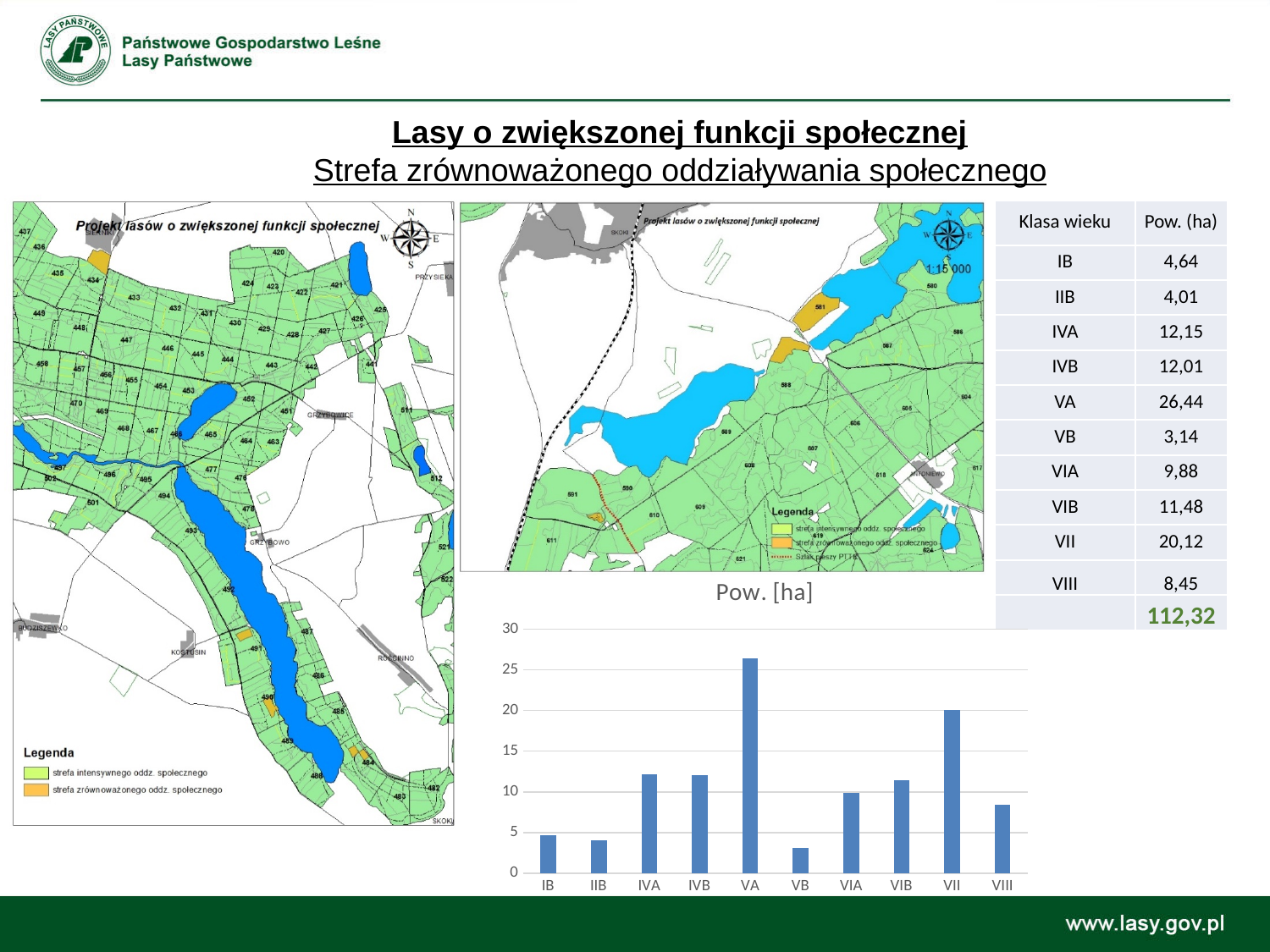
What is the title of the bar chart? Pow. [ha] What kind of chart is shown at the bottom of the slide? bar chart How many age classes (categories) are shown on the x axis of the bar chart? 10 Is the value for VII in the bar chart greater or less than 15? greater In the bar chart, does the value rise or fall from VA to VB? fall In the bar chart, which is larger: the value for VII or the value for VIA? VII What colour are the bars in the chart? blue Is the value for VA in the bar chart greater or less than 25? greater Is the value for VIII in the bar chart greater or less than 10? less Which age class has the lowest bar in the chart? VB Which age class has the highest bar in the chart? VA